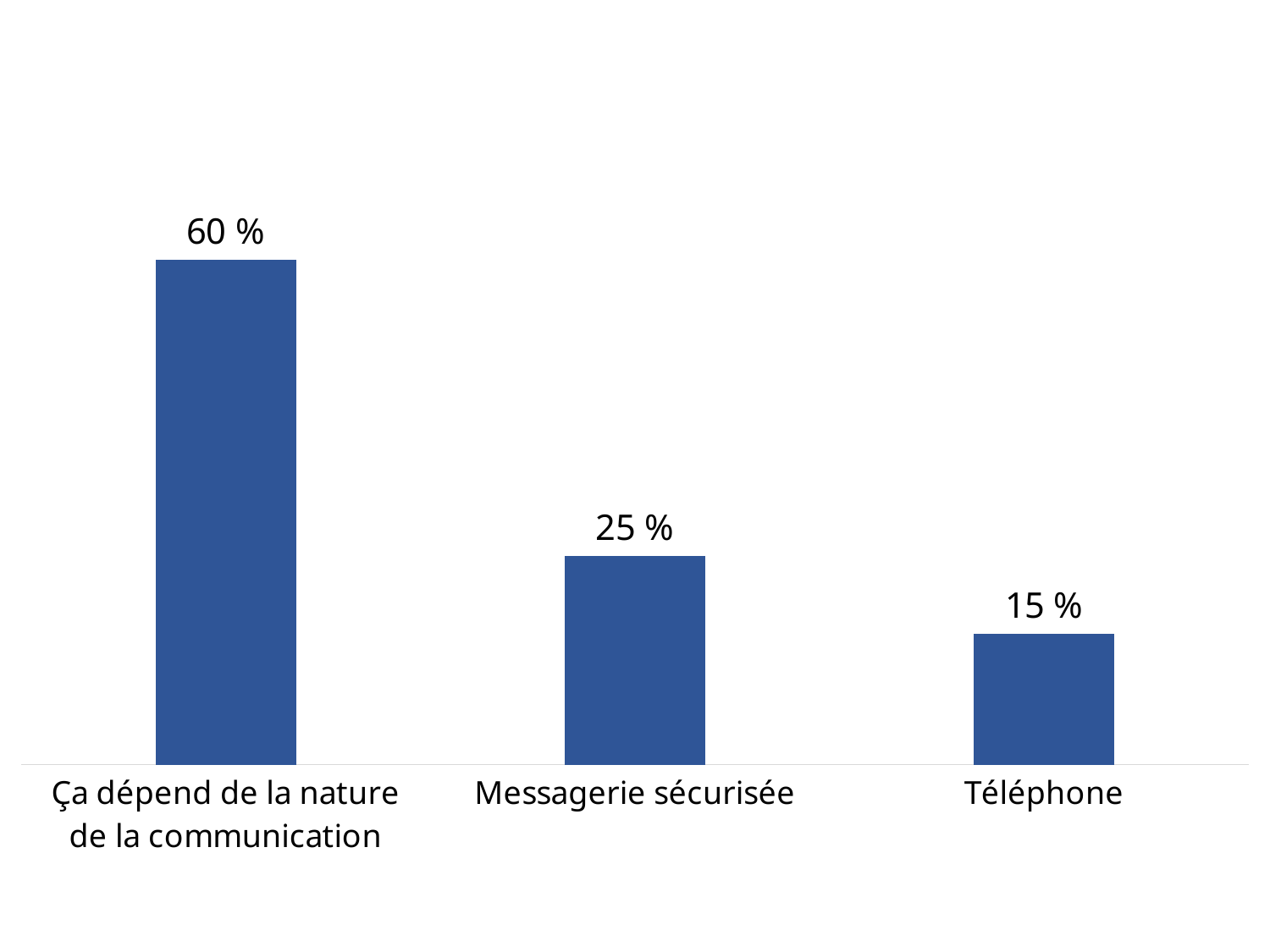
Which category has the highest value? Ça dépend de la nature de la communication How many categories are shown in the chart? 3 What kind of chart is shown on the slide? Bar chart What is the value for "Téléphone"? 15 % Do the values rise or fall from left to right across the categories? Fall Which category has the lowest value? Téléphone What is the difference between the values for "Messagerie sécurisée" and "Téléphone"? 10 % Which is larger, the value for "Messagerie sécurisée" or the value for "Téléphone"? Messagerie sécurisée What colour are the bars in the chart? Blue What is the value for "Ça dépend de la nature de la communication"? 60 % What is the value for "Messagerie sécurisée"? 25 % What is the difference between the values for "Ça dépend de la nature de la communication" and "Messagerie sécurisée"? 35 %